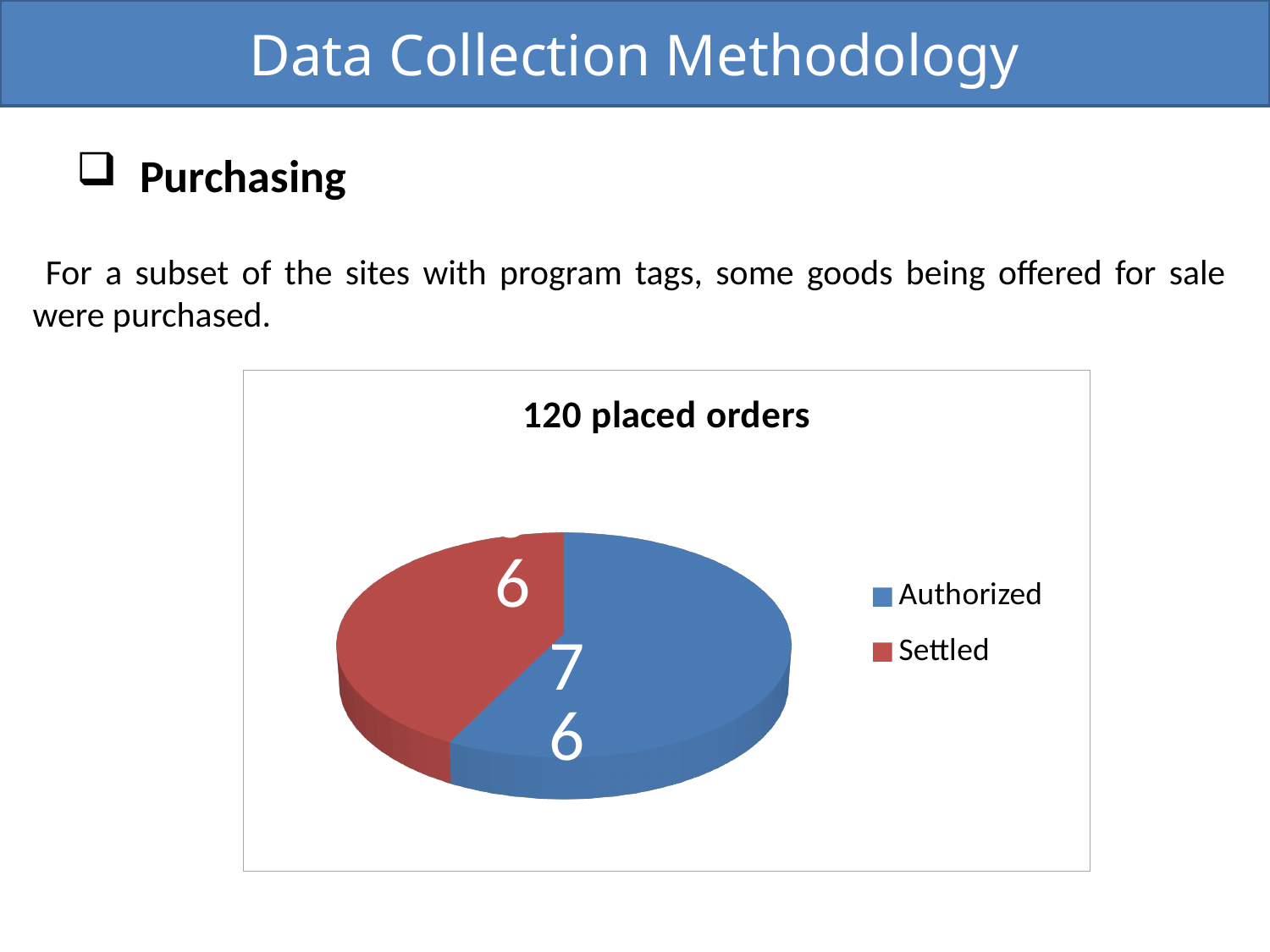
What value is labelled on the Authorized slice? 76 Which is larger, the Authorized slice or the Settled slice? Authorized What is the title of the chart? 120 placed orders Which category has the smallest slice of the pie? Settled What kind of chart is shown on the slide? pie chart How many categories does the pie chart's legend list? 2 Which category has the largest slice of the pie? Authorized What colour represents Settled in the pie chart? red